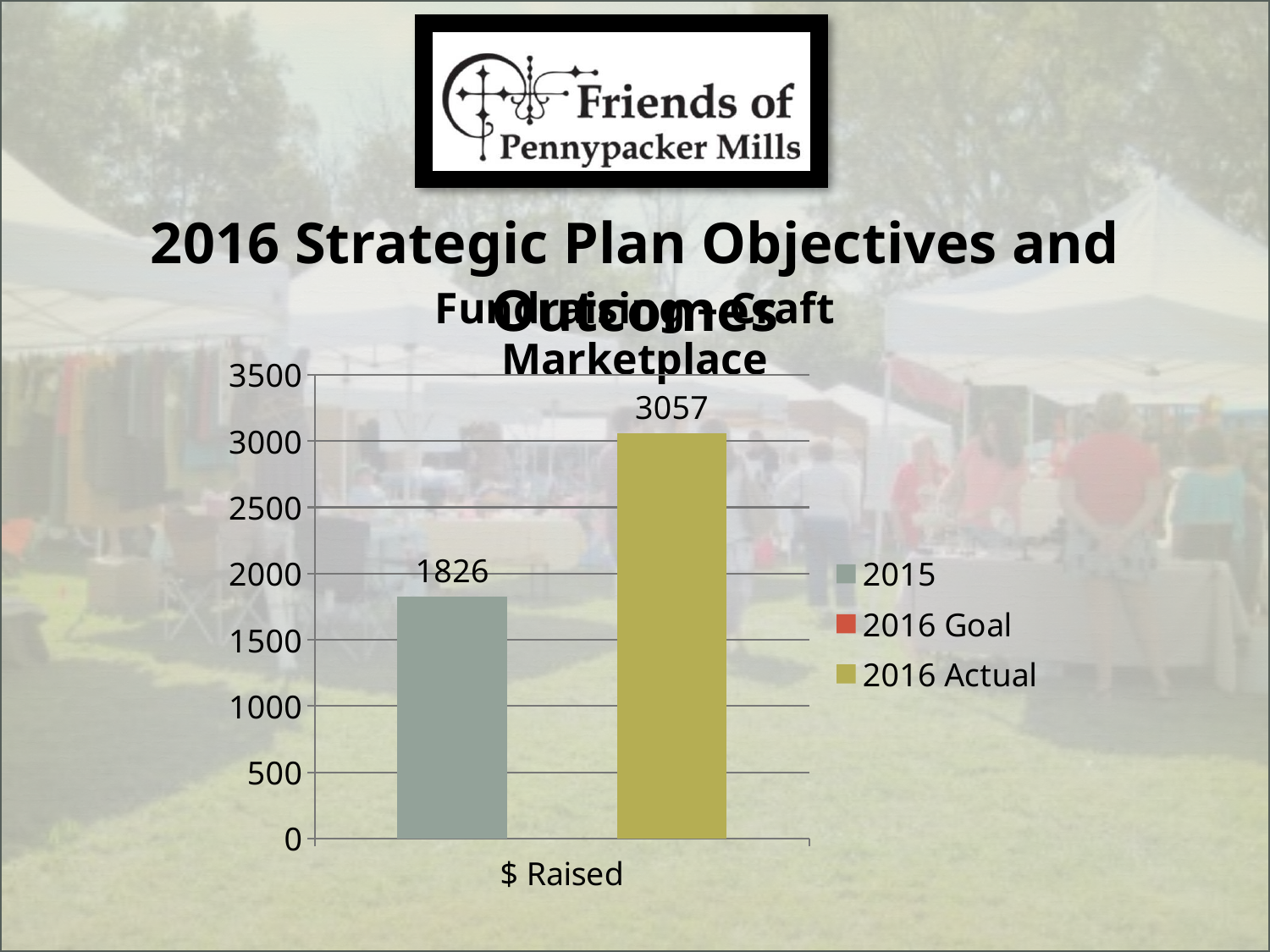
Which is larger, the 2015 value or the 2016 Actual value? 2016 Actual What is the difference between the 2016 Actual and 2015 values for $ Raised? 1231 Is the value for 2016 Actual greater or less than 3000? greater What kind of chart is shown on the slide? bar chart How many series does the legend list? 3 How many categories are shown on the x axis? 1 What is the label of the category on the x axis? $ Raised Which series has the highest value for $ Raised? 2016 Actual Is the value for 2015 greater or less than 2000? less Which plotted series has the lowest value for $ Raised? 2015 What is the value for 2015 in the $ Raised category? 1826 What is the value for 2016 Actual in the $ Raised category? 3057